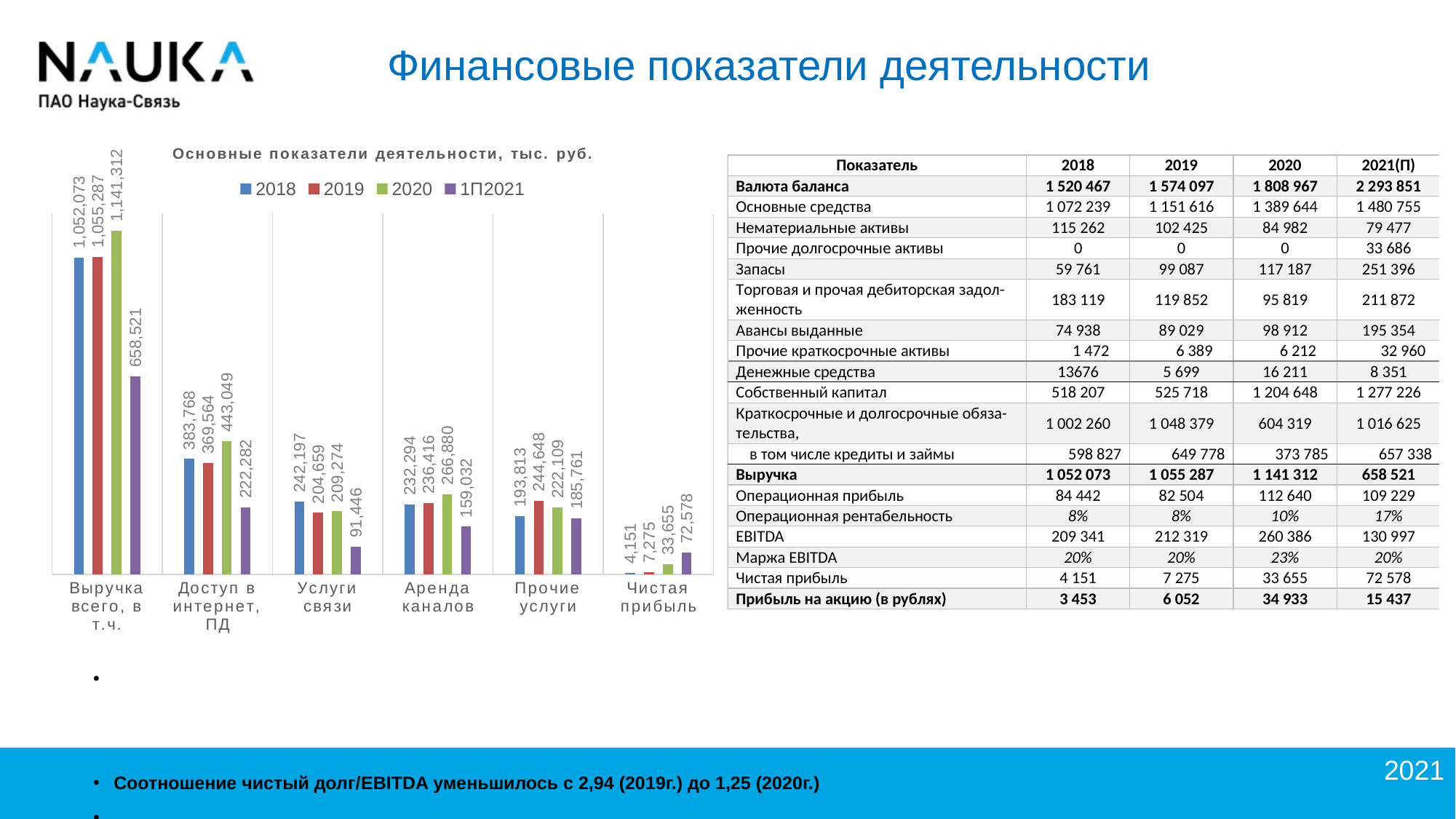
What is the 2019 value for Прочие услуги? 244,648 How many series does the legend list? 4 What is the title of the chart? Основные показатели деятельности, тыс. руб. Which year has the highest value for Выручка всего, в т.ч.? 2020 How many categories are shown on the x axis of the chart? 6 What kind of chart is shown on the slide? bar chart Which year has the lowest value for Чистая прибыль? 2018 What is the 1П2021 value for Чистая прибыль? 72,578 What is the difference between the 2020 and 2019 values for Аренда каналов? 30,464 What is the 2020 value for Доступ в интернет, ПД? 443,049 What is the difference between the 2020 and 2018 values for Выручка всего, в т.ч.? 89,239 For Услуги связи, which is larger: the 2018 value or the 2020 value? 2018